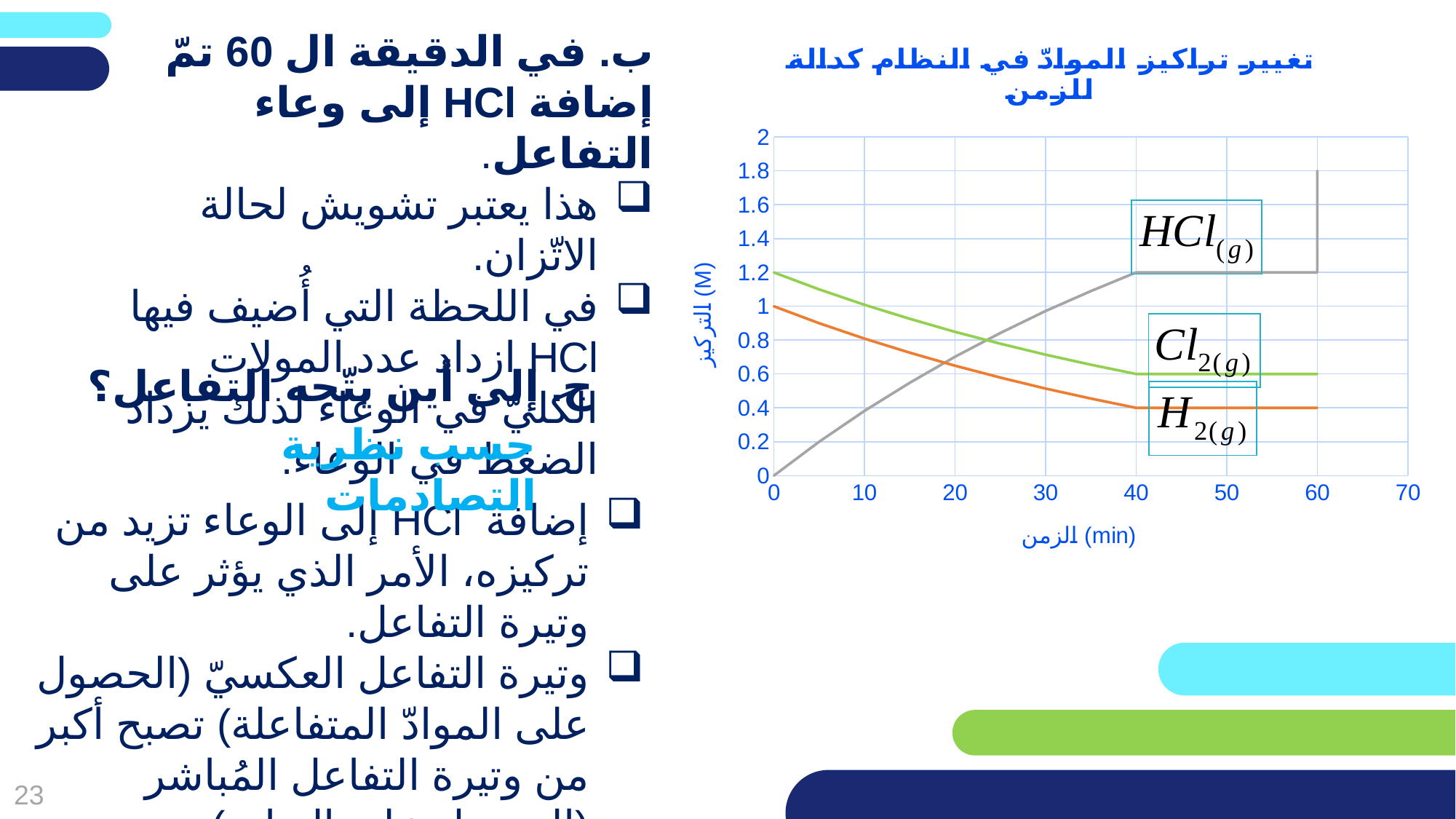
What is the label of the x axis? الزمن (min) What is the concentration of HCl(g) at 40 min? 1.2 What kind of chart is shown on the slide? line chart Does the concentration of Cl2(g) rise or fall between 0 and 40 min? falls At 10 min, which is larger: the concentration of Cl2(g) or of HCl(g)? Cl2(g) By how much does the concentration of Cl2(g) decrease from 0 min to 40 min? 0.6 What is the concentration of H2(g) at time 0 min? 1 Does the concentration of HCl(g) rise or fall between 0 and 40 min? rises What is the concentration of Cl2(g) at time 0 min? 1.2 Which substance has the lowest concentration at 40 min? H2(g) How many series (substances) are plotted on the chart? 3 Is the concentration of HCl(g) at 10 min greater or less than 0.6? less